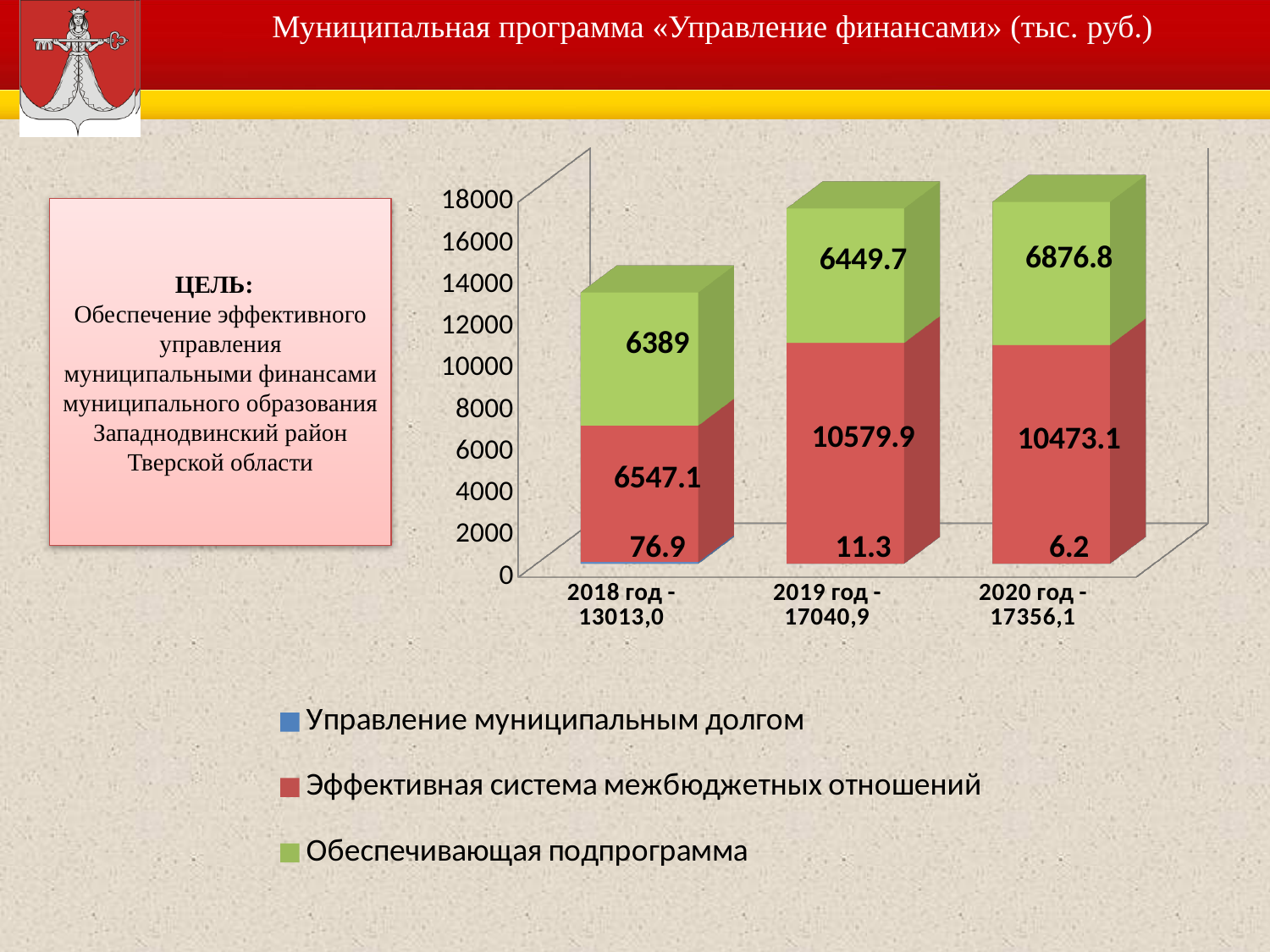
What is the difference between the Эффективная система межбюджетных отношений values for 2019 год and 2020 год? 106.8 In which year is the value of Обеспечивающая подпрограмма the highest? 2020 год How many series does the legend list? 3 What is the value of Эффективная система межбюджетных отношений for 2019 год? 10579.9 Which is larger: Обеспечивающая подпрограмма in 2018 год or in 2019 год? 2019 год What is the value of Управление муниципальным долгом for 2020 год? 6.2 In which year is the value of Управление муниципальным долгом the lowest? 2020 год How many year categories are shown on the x axis? 3 What kind of chart is shown on the slide? Stacked bar chart Which colour represents Эффективная система межбюджетных отношений in the chart? Red What is the total of the stacked bar for 2019 год? 17040.9 What is the value of Обеспечивающая подпрограмма for 2018 год? 6389